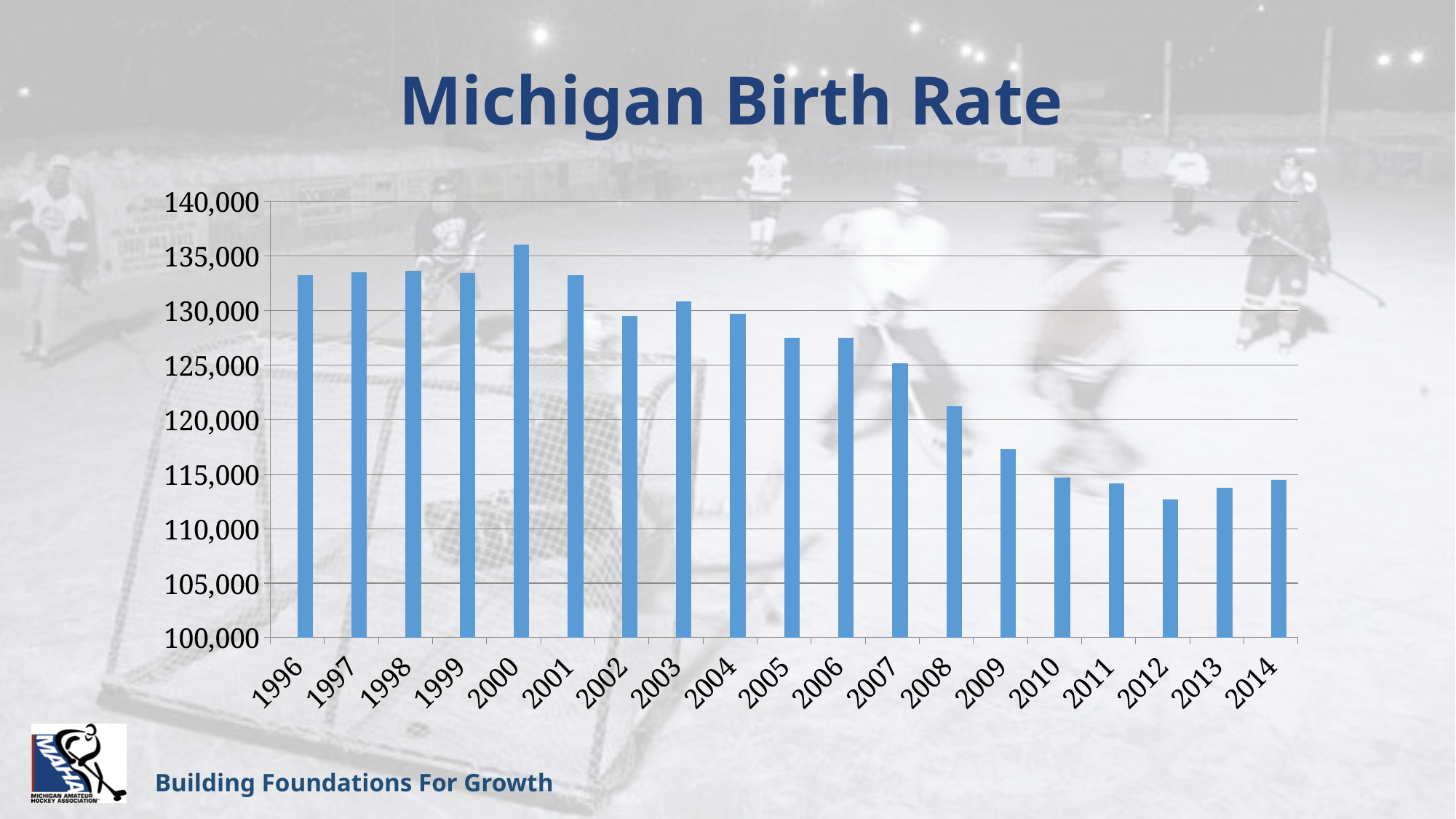
How many years are shown on the x axis of the chart? 19 Which year has the lowest birth rate in the chart? 2012 What is the title of the chart? Michigan Birth Rate Is the value for 2000 greater or less than 135,000? greater Which is larger, the value for 2000 or the value for 2014? 2000 Is the value for 2008 greater or less than 120,000? greater Is the value for 2012 greater or less than 115,000? less Which is larger, the value for 1996 or the value for 2002? 1996 Overall, do the values rise or fall from 1996 to 2014? Fall What type of chart is shown on the slide? Bar chart Which year has the highest birth rate in the chart? 2000